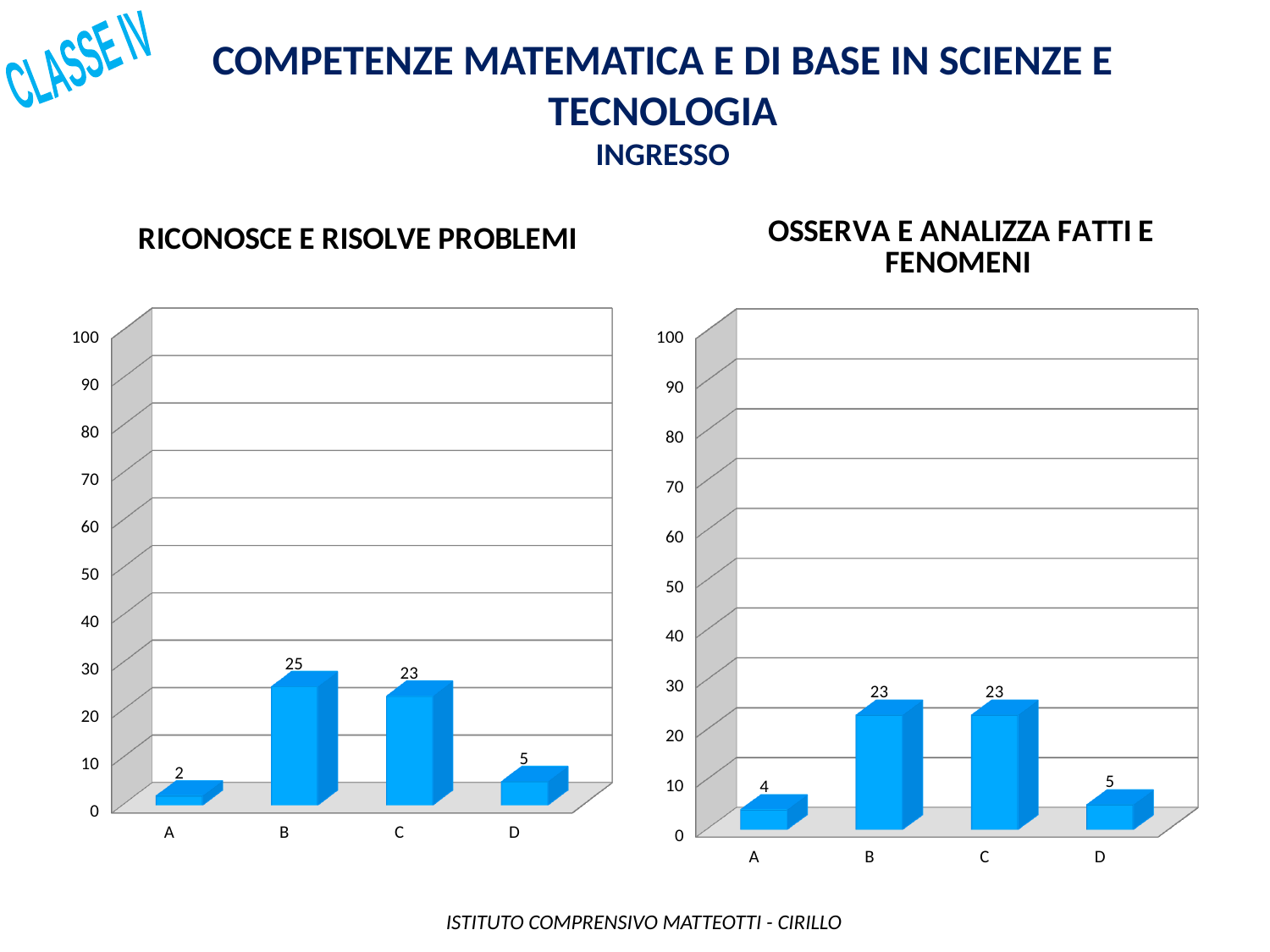
In the 'RICONOSCE E RISOLVE PROBLEMI' chart, which is larger, the value for C or the value for D? C In the 'OSSERVA E ANALIZZA FATTI E FENOMENI' chart, what is the value for category A? 4 What kind of chart is the 'RICONOSCE E RISOLVE PROBLEMI' chart? Bar chart In the 'RICONOSCE E RISOLVE PROBLEMI' chart, what is the value for category A? 2 In the 'OSSERVA E ANALIZZA FATTI E FENOMENI' chart, what is the difference between the values for C and D? 18 In the 'RICONOSCE E RISOLVE PROBLEMI' chart, which category has the highest value? B In the 'RICONOSCE E RISOLVE PROBLEMI' chart, what is the value for category B? 25 In the 'RICONOSCE E RISOLVE PROBLEMI' chart, what is the difference between the values for B and C? 2 How many categories are shown in the 'OSSERVA E ANALIZZA FATTI E FENOMENI' chart? 4 In the 'RICONOSCE E RISOLVE PROBLEMI' chart, which category has the lowest value? A In the 'OSSERVA E ANALIZZA FATTI E FENOMENI' chart, which category has the lowest value? A In the 'OSSERVA E ANALIZZA FATTI E FENOMENI' chart, what is the value for category D? 5